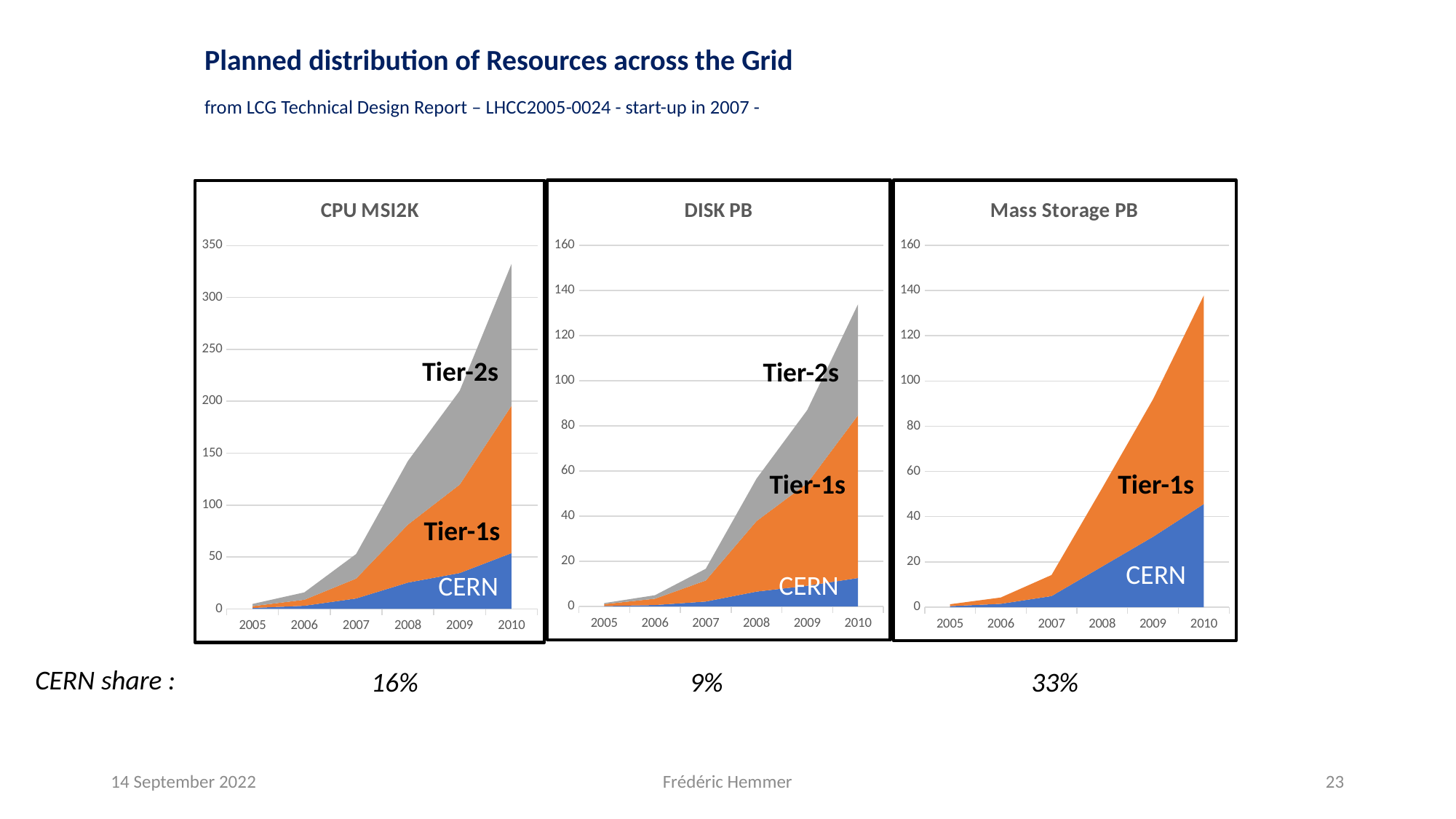
In the CPU MSI2K chart, is the total value for 2010 greater or less than 300? greater In the CPU MSI2K chart, do the total values rise or fall from 2005 to 2010? rise In the DISK PB chart, is the total value for 2010 greater or less than 120? greater What kind of chart is the CPU MSI2K chart? stacked area chart How many years are shown on the x axis of the DISK PB chart? 6 What is the title of the rightmost chart? Mass Storage PB In the Mass Storage PB chart, is the CERN value for 2010 greater or less than 40? greater In the Mass Storage PB chart, which year has the lowest total value? 2005 How many series are labelled in the CPU MSI2K chart? 3 In the CPU MSI2K chart, which year has the highest total value? 2010 How many series are labelled in the Mass Storage PB chart? 2